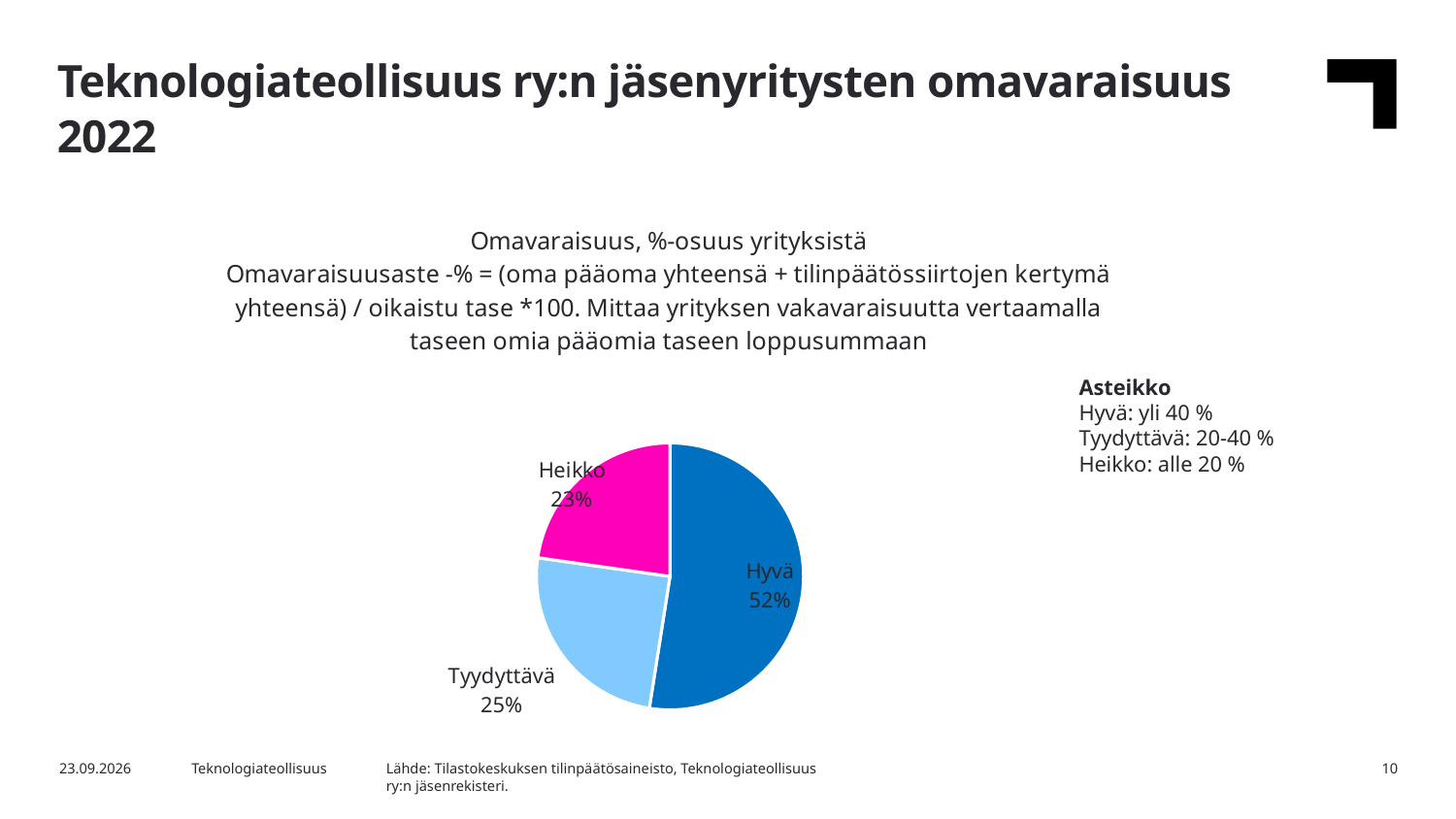
What is the difference in percentage points between the Hyvä and Tyydyttävä shares? 27 Which category has the smallest share of the pie? Heikko What is the difference in percentage points between the Tyydyttävä and Heikko shares? 2 How many categories does the pie chart show? 3 What kind of chart is shown on the slide? Pie chart What share of companies falls into the Tyydyttävä category? 25% What is the combined share of the Tyydyttävä and Heikko categories? 48% What share of companies falls into the Hyvä category? 52% Which category has the largest share of the pie? Hyvä What colour is the Heikko slice of the pie? Magenta (pink) What share of companies falls into the Heikko category? 23% Which is larger, the share for Hyvä or the share for Heikko? Hyvä